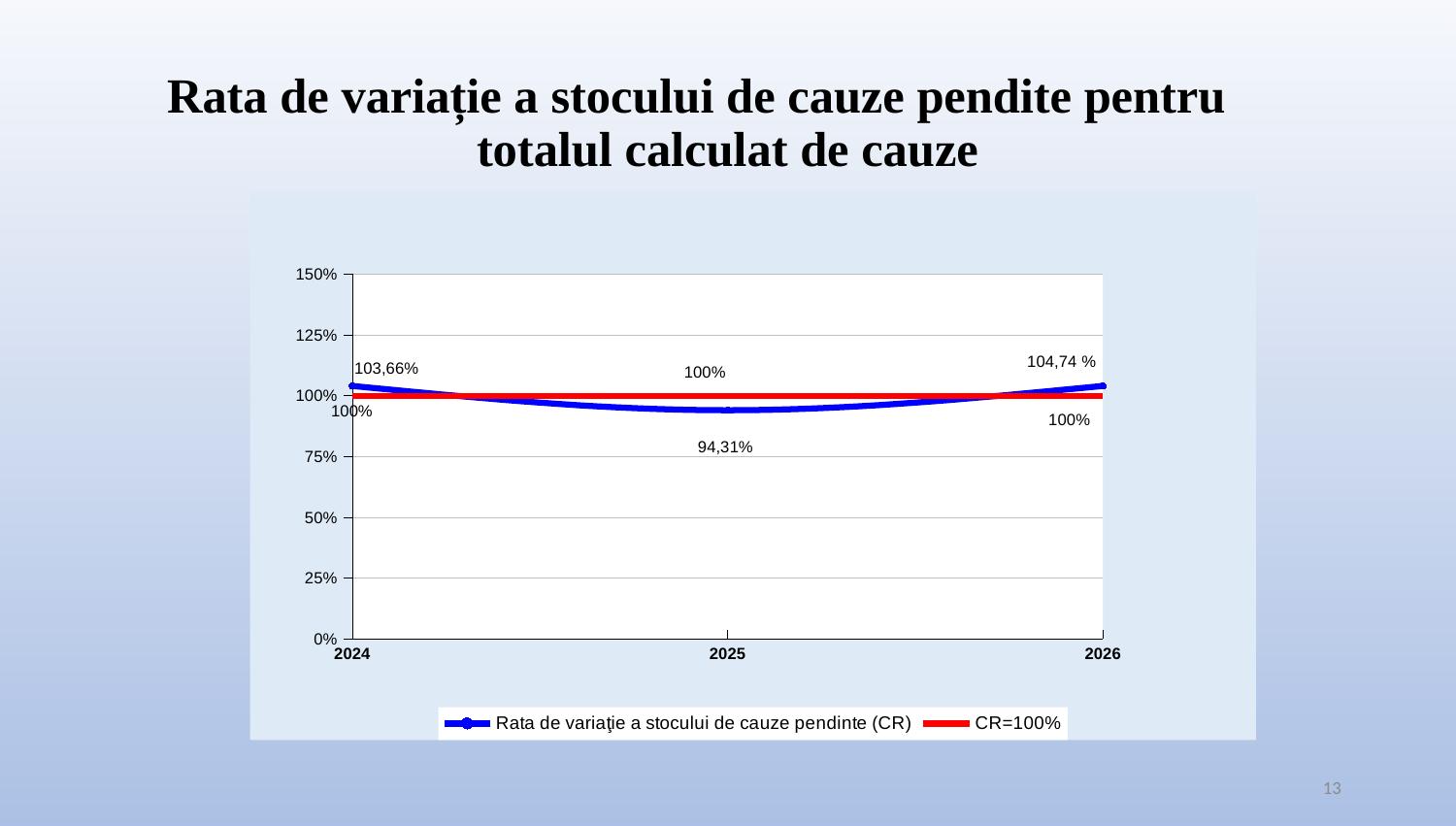
What is the value of Rata de variaţie a stocului de cauze pendinte (CR) for 2025? 94,31% What is the value of Rata de variaţie a stocului de cauze pendinte (CR) for 2026? 104,74 % What is the difference between the CR values for 2024 and 2025? 9,35 percentage points How many years are shown on the x axis? 3 How many series does the legend list? 2 What is the value of Rata de variaţie a stocului de cauze pendinte (CR) for 2024? 103,66% Is the CR value for 2025 greater or less than 100%? less What type of chart is shown on the slide? Line chart Which year has a higher CR value, 2024 or 2025? 2024 In which year is Rata de variaţie a stocului de cauze pendinte (CR) the lowest? 2025 What is the value of the CR=100% series in 2025? 100% In which year is Rata de variaţie a stocului de cauze pendinte (CR) the highest? 2026